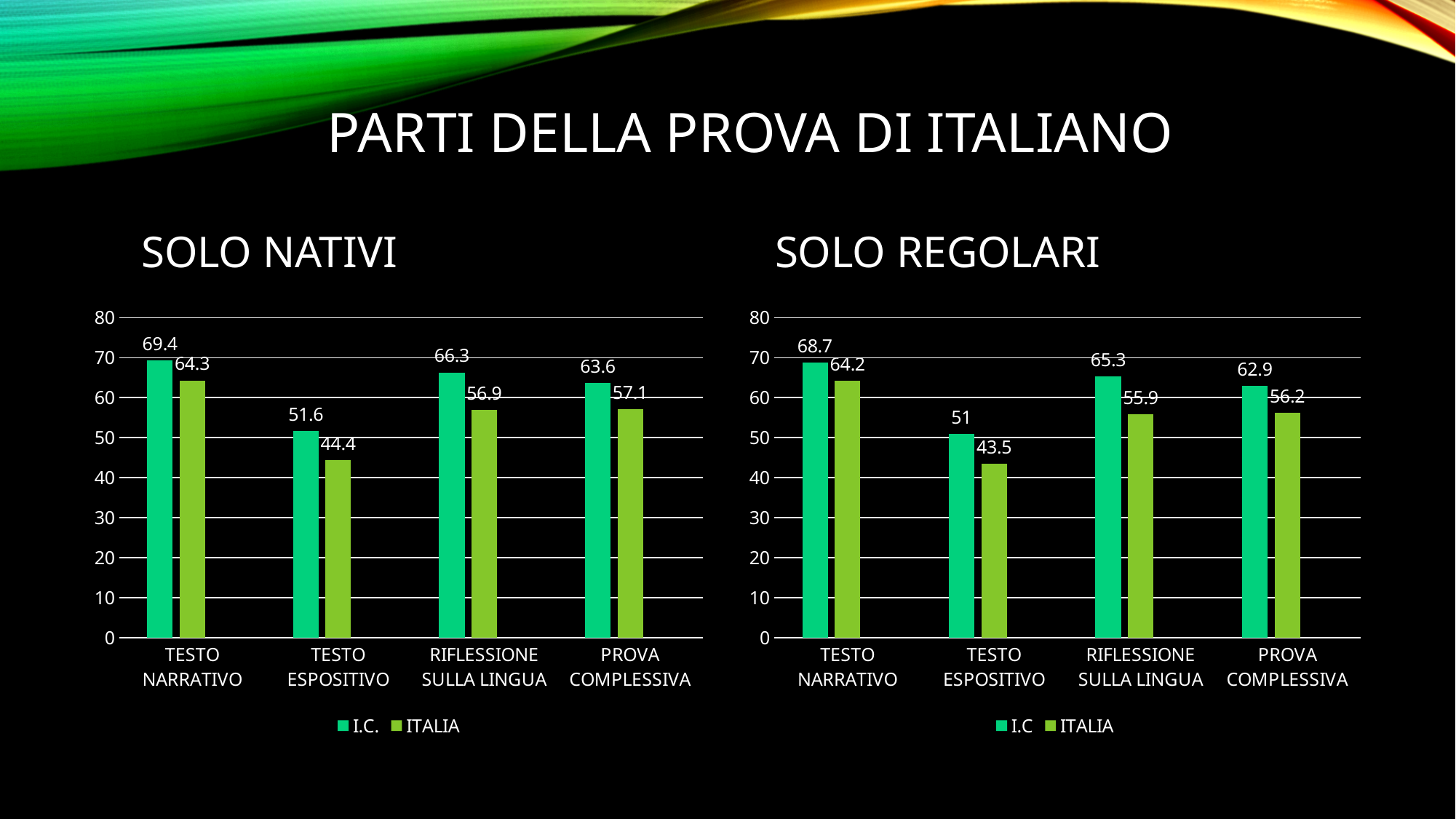
In the SOLO NATIVI chart, what is the I.C. value for TESTO NARRATIVO? 69.4 What kind of chart is the SOLO NATIVI chart? Bar chart In the SOLO NATIVI chart, what is the ITALIA value for TESTO ESPOSITIVO? 44.4 In the SOLO REGOLARI chart, what is the difference between the I.C and ITALIA values for TESTO NARRATIVO? 4.5 In the SOLO REGOLARI chart, which is larger for PROVA COMPLESSIVA: I.C or ITALIA? I.C In the SOLO REGOLARI chart, what is the ITALIA value for PROVA COMPLESSIVA? 56.2 How many series does the legend of the SOLO REGOLARI chart list? 2 How many categories are shown on the x axis of the SOLO NATIVI chart? 4 In the SOLO REGOLARI chart, which category has the highest ITALIA value? TESTO NARRATIVO In the SOLO NATIVI chart, what is the difference between the I.C. and ITALIA values for TESTO ESPOSITIVO? 7.2 In the SOLO NATIVI chart, which category has the lowest I.C. value? TESTO ESPOSITIVO In the SOLO REGOLARI chart, what is the I.C value for RIFLESSIONE SULLA LINGUA? 65.3